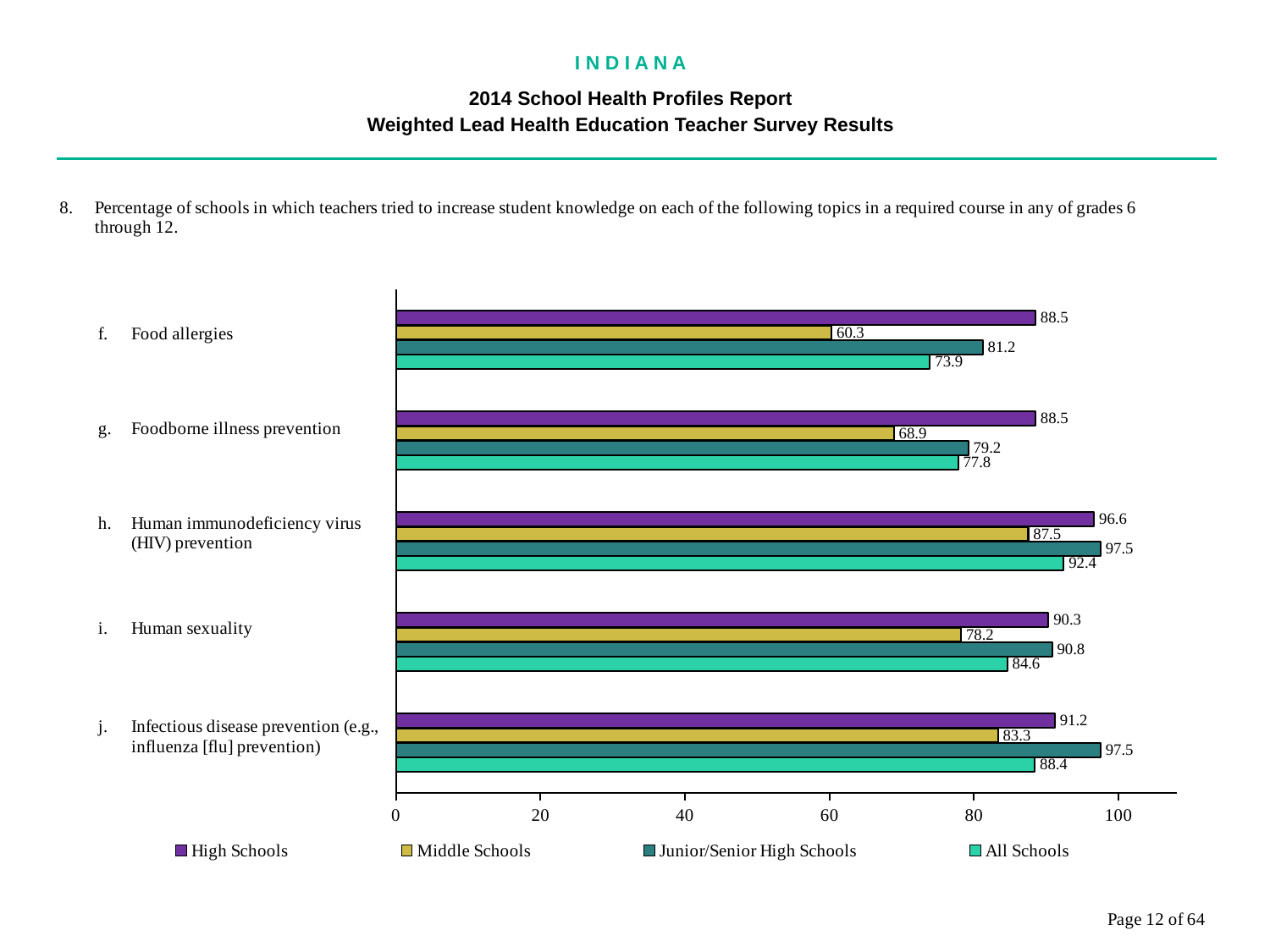
How many series does the legend list? 4 Which topic has the highest High Schools value? Human immunodeficiency virus (HIV) prevention What is the value for All Schools for Human sexuality? 84.6 Which legend entry is shown in purple? High Schools Which topic has the lowest Middle Schools value? Food allergies What kind of chart is shown on the slide? Bar chart How many topics are shown on the chart? 5 What is the value for Middle Schools for Foodborne illness prevention? 68.9 What is the value for High Schools for Food allergies? 88.5 What is the value for Junior/Senior High Schools for Infectious disease prevention? 97.5 What is the difference between the High Schools and Middle Schools values for Food allergies? 28.2 Which is larger for Human sexuality: the High Schools value or the Junior/Senior High Schools value? Junior/Senior High Schools